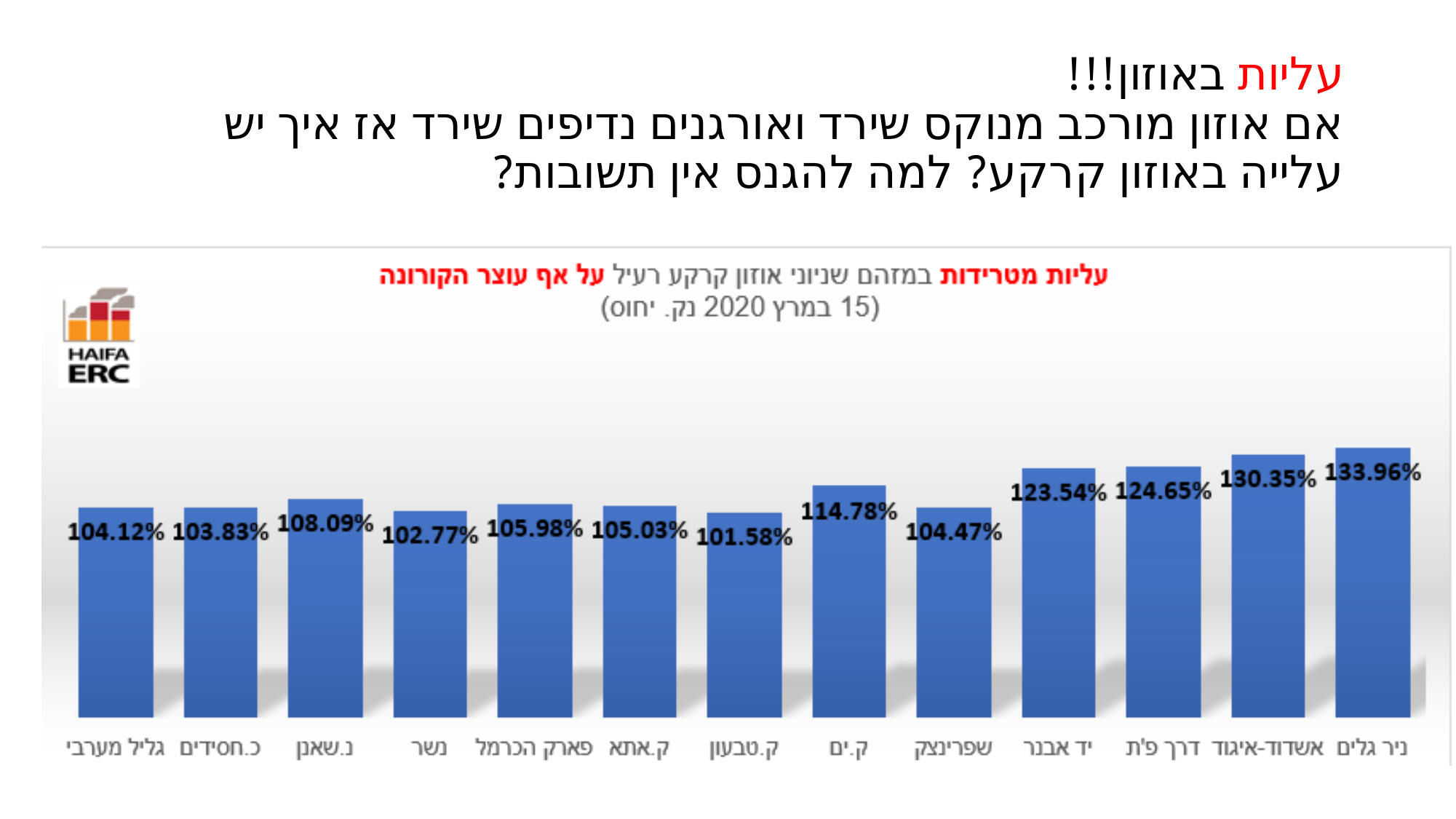
What is the difference between the values for ניר גלים and ק.טבעון? 32.38% How many categories are shown in the chart? 13 What is the difference between the values for דרך פ"ת and יד אבנר? 1.11% What colour are the bars in the chart? blue What is the value for ניר גלים? 133.96% What kind of chart is shown on the slide? bar chart What is the value for אשדוד-איגוד? 130.35% What is the value for ק.ים? 114.78% What is the value for נשר? 102.77% Which category has the lowest value? ק.טבעון Which is larger, the value for נ.שאנן or the value for פארק הכרמל? נ.שאנן Which category has the highest value? ניר גלים